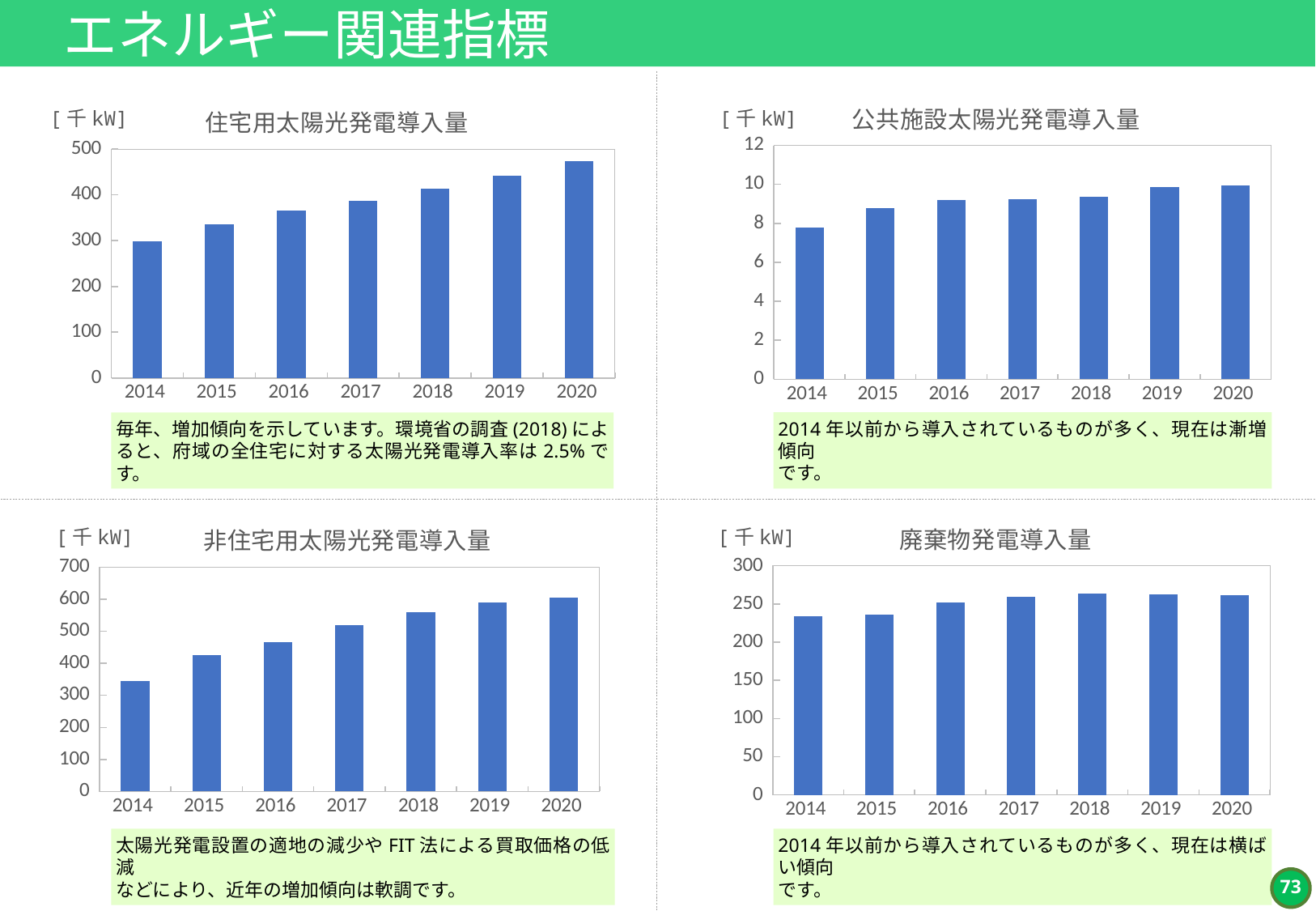
In the 住宅用太陽光発電導入量 chart, do the values rise or fall from 2014 to 2020? rise In the 公共施設太陽光発電導入量 chart, is the value for 2015 greater or less than 8? greater What unit is shown above the y axis of the 廃棄物発電導入量 chart? 千kW In the 住宅用太陽光発電導入量 chart, is the value for 2020 greater or less than 400? greater In the 公共施設太陽光発電導入量 chart, which year has the lowest value? 2014 In the 廃棄物発電導入量 chart, is the value for 2018 greater or less than 250? greater In the 住宅用太陽光発電導入量 chart, which year has the lowest value? 2014 In the 非住宅用太陽光発電導入量 chart, which is larger, the value for 2014 or the value for 2020? 2020 How many years are shown on the x axis of the 公共施設太陽光発電導入量 chart? 7 What kind of chart is the 住宅用太陽光発電導入量 chart? bar chart In the 住宅用太陽光発電導入量 chart, which year has the highest value? 2020